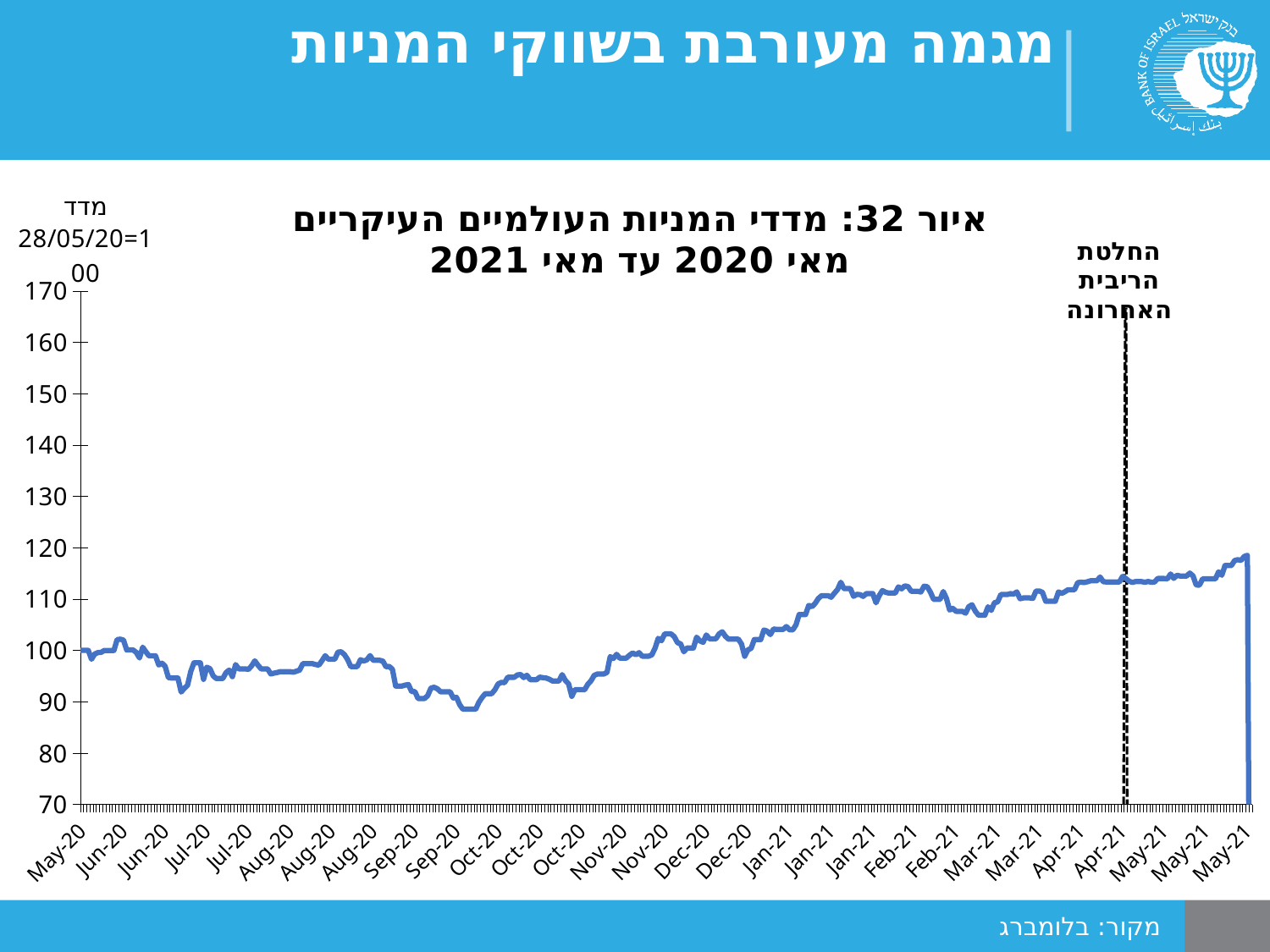
Is the value of the index around Jan-21 greater or less than 120? less What is the title of the chart? איור 32: מדדי המניות העולמיים העיקריים מאי 2020 עד מאי 2021 Overall, does the index rise or fall from May-20 to May-21? rise Is the value of the index around Sep-20 greater or less than 100? less Is the index value in Mar-21 higher or lower than in Sep-20? higher Is the value of the index around Mar-21 greater or less than 100? greater What is the source cited at the bottom of the slide? בלומברג Around which month does the index reach its highest point? May-21 What is the highest value shown on the y axis? 170 Around which month does the index reach its lowest point? Sep-20 What kind of chart is shown on the slide? line chart